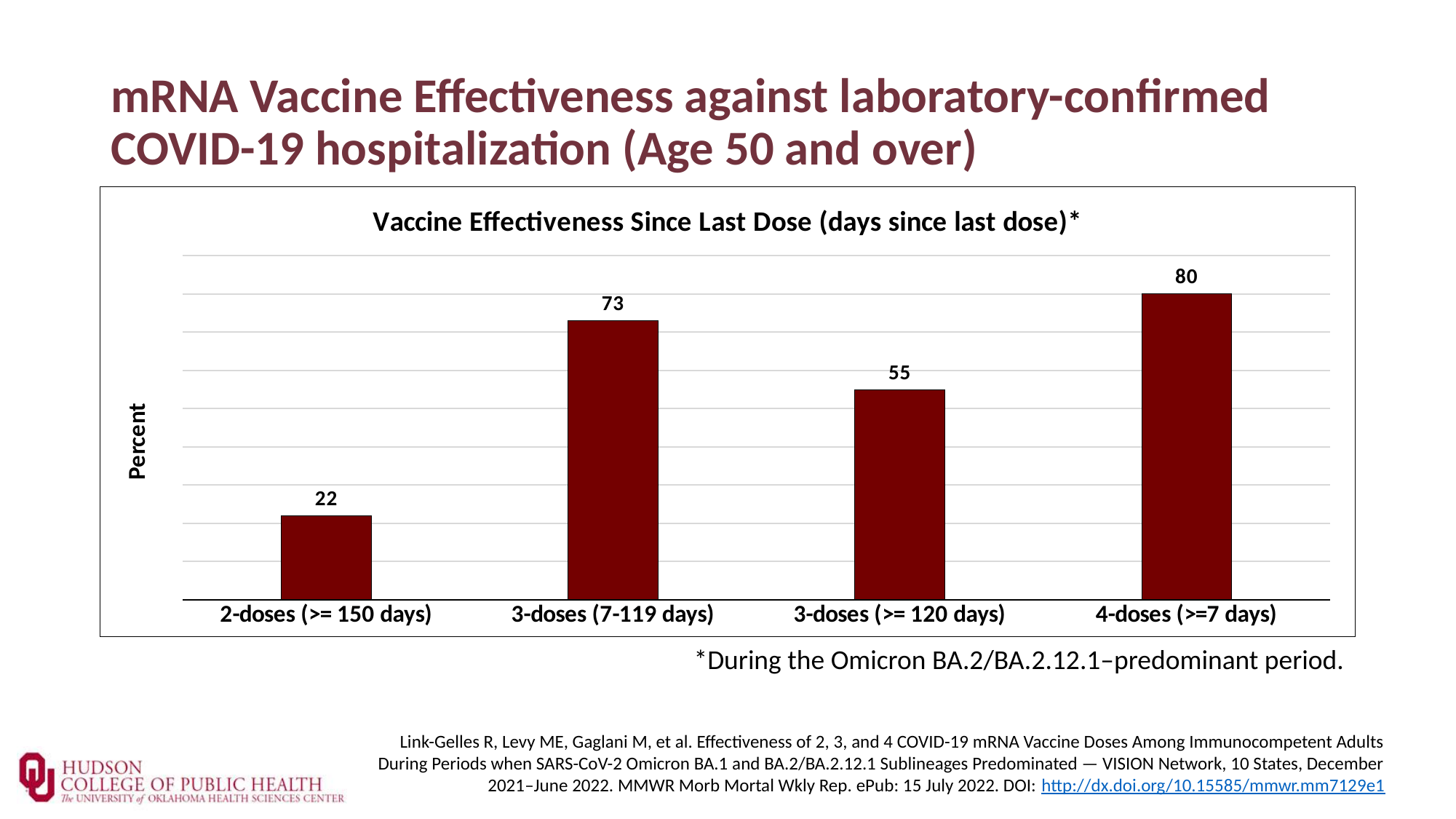
Which category has the lowest vaccine effectiveness? 2-doses (>= 150 days) What kind of chart is shown on the slide? Bar chart What is the vaccine effectiveness value for 3-doses (7-119 days)? 73 What is the vaccine effectiveness value for 3-doses (>= 120 days)? 55 How many categories are shown on the x axis of the chart? 4 What is the difference between the values for 4-doses (>=7 days) and 2-doses (>= 150 days)? 58 What is the difference between the values for 3-doses (7-119 days) and 3-doses (>= 120 days)? 18 Which category has the highest vaccine effectiveness? 4-doses (>=7 days) What is the vaccine effectiveness value for 4-doses (>=7 days)? 80 What is the vaccine effectiveness value for 2-doses (>= 150 days)? 22 Which is larger, the value for 3-doses (7-119 days) or the value for 4-doses (>=7 days)? 4-doses (>=7 days) What is the title of the chart? Vaccine Effectiveness Since Last Dose (days since last dose)*